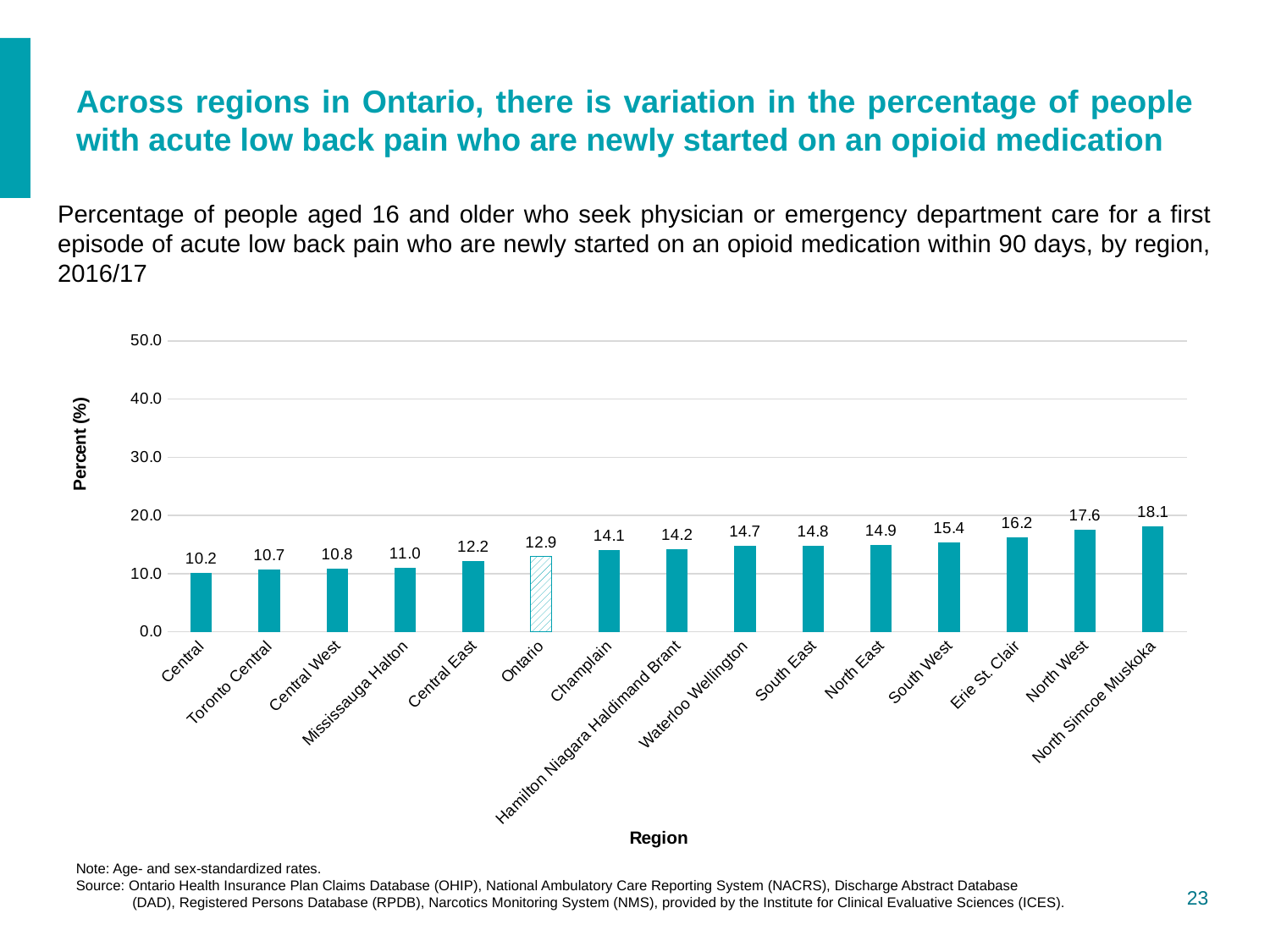
Which is larger, the value for Champlain or the value for South West? South West What is the difference between the values for North West and Ontario? 4.7 Is the value for Central East greater or less than 10.0? greater What is the label of the y axis? Percent (%) What kind of chart is this? bar chart What is the value for Erie St. Clair? 16.2 What is the value for Ontario? 12.9 How many regions are shown on the x axis? 15 Which region has the highest value? North Simcoe Muskoka What is the difference between the values for North Simcoe Muskoka and Central? 7.9 Which region has the lowest value? Central What is the value for Mississauga Halton? 11.0